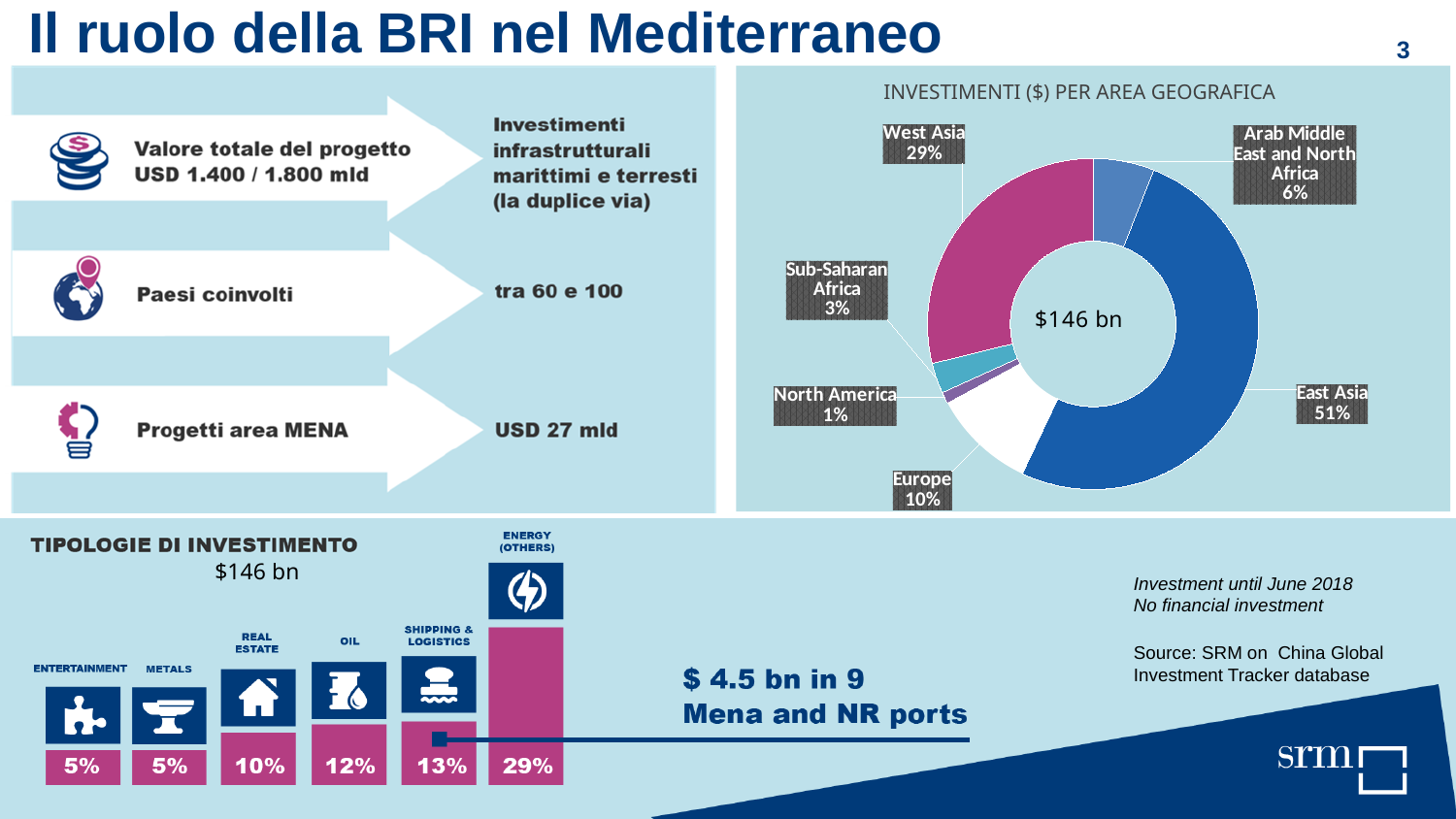
What kind of chart is 'TIPOLOGIE DI INVESTIMENTO'? Bar chart In the donut chart 'INVESTIMENTI ($) PER AREA GEOGRAFICA', what share does West Asia have? 29% In the donut chart 'INVESTIMENTI ($) PER AREA GEOGRAFICA', how many geographic areas are shown? 6 What total value is printed in the centre of the donut chart 'INVESTIMENTI ($) PER AREA GEOGRAFICA'? $146 bn In the donut chart 'INVESTIMENTI ($) PER AREA GEOGRAFICA', which area has the smallest share? North America In the bar chart 'TIPOLOGIE DI INVESTIMENTO', which category has the highest value? Energy (Others) In the bar chart 'TIPOLOGIE DI INVESTIMENTO', how many categories are shown? 6 In the bar chart 'TIPOLOGIE DI INVESTIMENTO', which is larger, Shipping & Logistics or Real Estate? Shipping & Logistics In the bar chart 'TIPOLOGIE DI INVESTIMENTO', what is the value for Oil? 12% In the donut chart 'INVESTIMENTI ($) PER AREA GEOGRAFICA', which area has the largest share? East Asia In the donut chart 'INVESTIMENTI ($) PER AREA GEOGRAFICA', what share does East Asia have? 51% In the donut chart 'INVESTIMENTI ($) PER AREA GEOGRAFICA', how many percentage points larger is East Asia's share than Europe's? 41